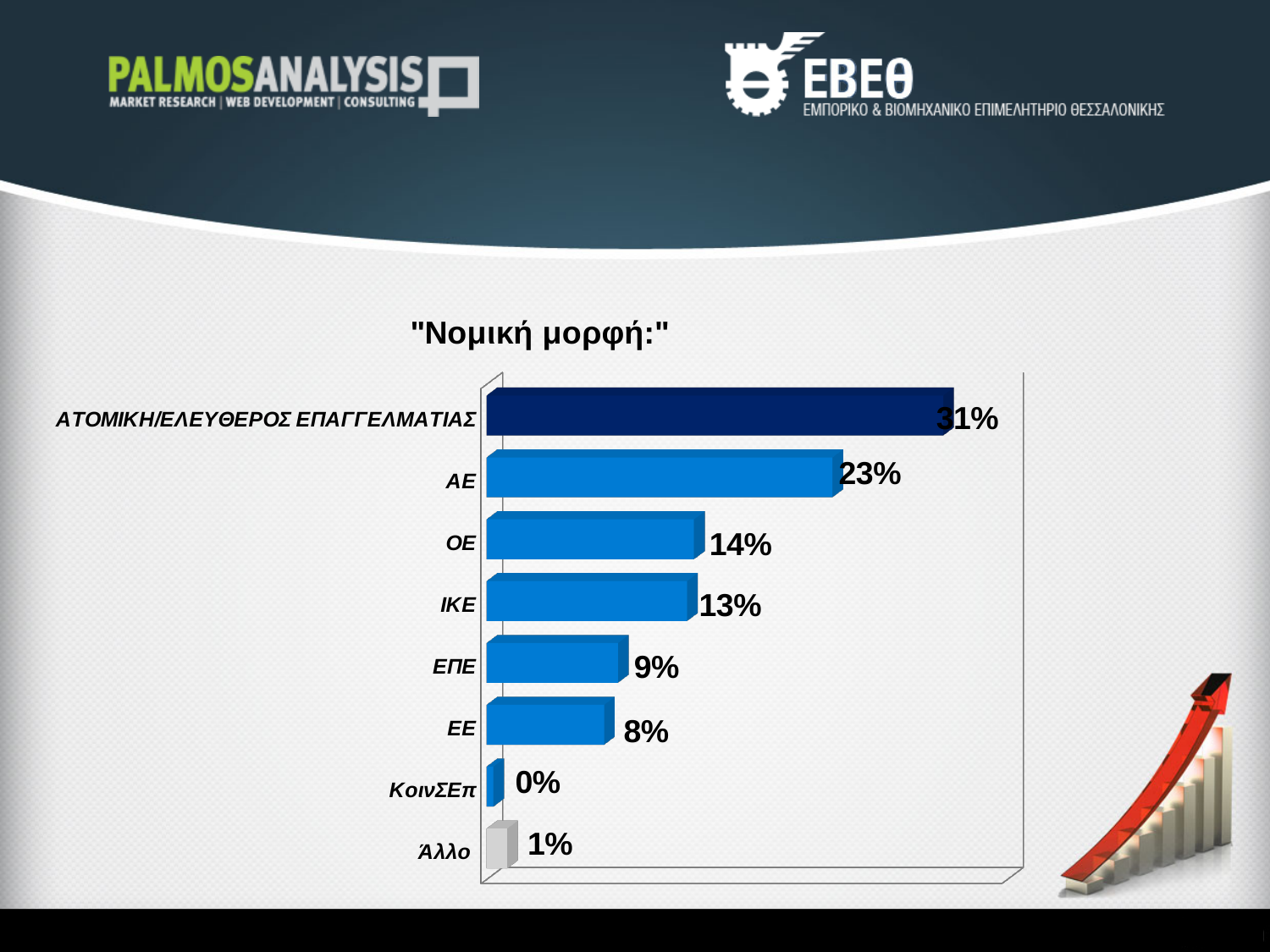
What is the value for Άλλο? 1% How many categories are shown in the chart? 8 What is the value for ΑΕ? 23% What is the title of the chart? "Νομική μορφή:" What is the value for ΙΚΕ? 13% What kind of chart is shown on the slide? Bar chart Which category has the highest value? ΑΤΟΜΙΚΗ/ΕΛΕΥΘΕΡΟΣ ΕΠΑΓΓΕΛΜΑΤΙΑΣ Which category has the lowest value? ΚοινΣΕπ What is the difference between the values for ΟΕ and ΕΠΕ? 5% What is the value for ΕΕ? 8% Which is larger, the value for ΟΕ or the value for ΙΚΕ? ΟΕ What is the difference between the values for ΑΤΟΜΙΚΗ/ΕΛΕΥΘΕΡΟΣ ΕΠΑΓΓΕΛΜΑΤΙΑΣ and ΑΕ? 8%